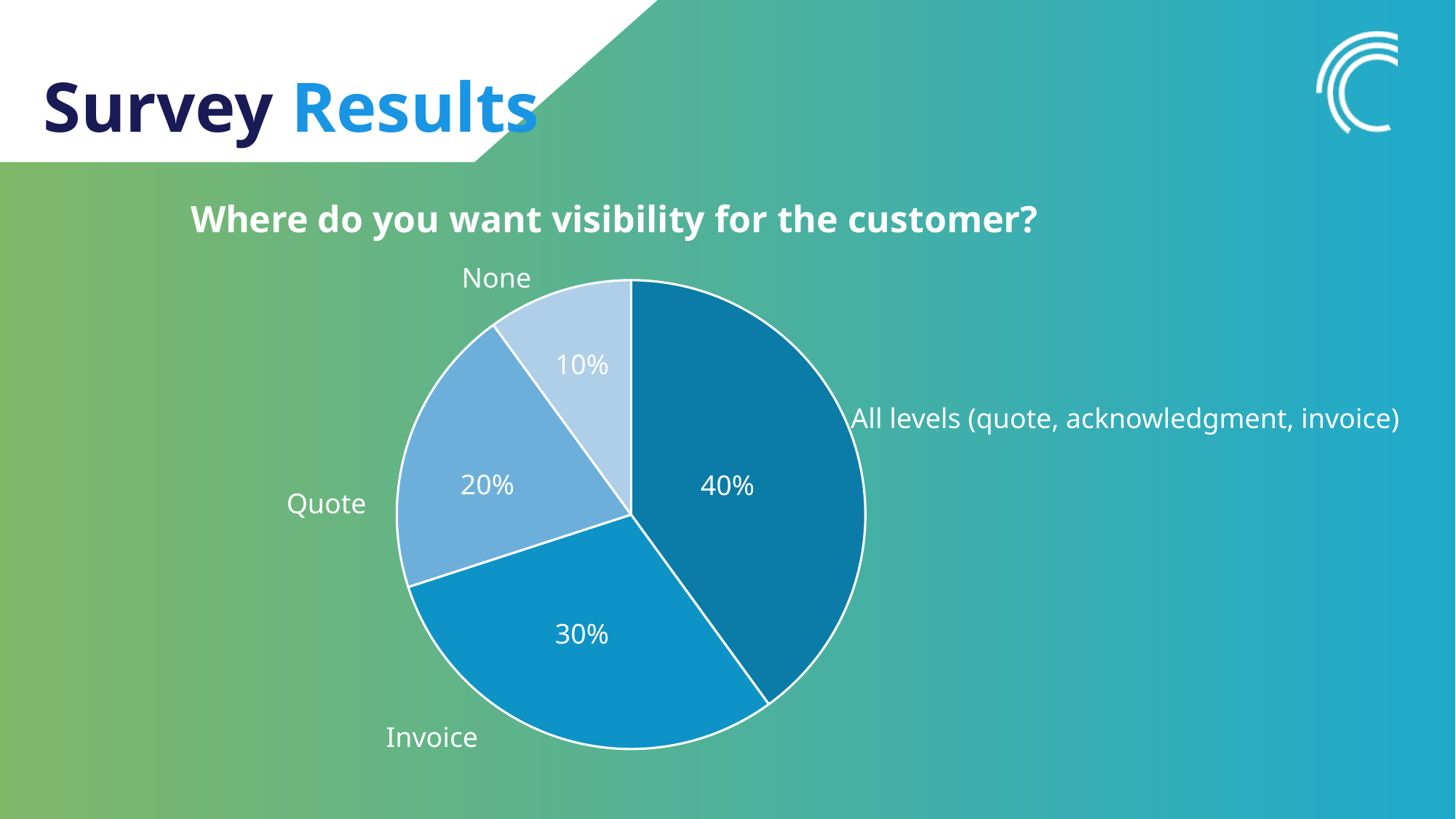
What percentage of respondents chose 'Quote'? 20% What percentage of respondents chose 'None'? 10% What is the difference in percentage points between 'Invoice' and 'Quote'? 10 percentage points Which category has the largest share of the pie? All levels (quote, acknowledgment, invoice) What type of chart is shown on the slide? Pie chart What is the title of the chart? Where do you want visibility for the customer? What percentage of respondents chose 'Invoice'? 30% Which category has the smallest share of the pie? None What percentage of respondents chose 'All levels (quote, acknowledgment, invoice)'? 40% How many categories are shown in the pie chart? 4 What is the difference in percentage points between the largest and smallest slices? 30 percentage points Which is larger, the share for 'Quote' or the share for 'None'? Quote